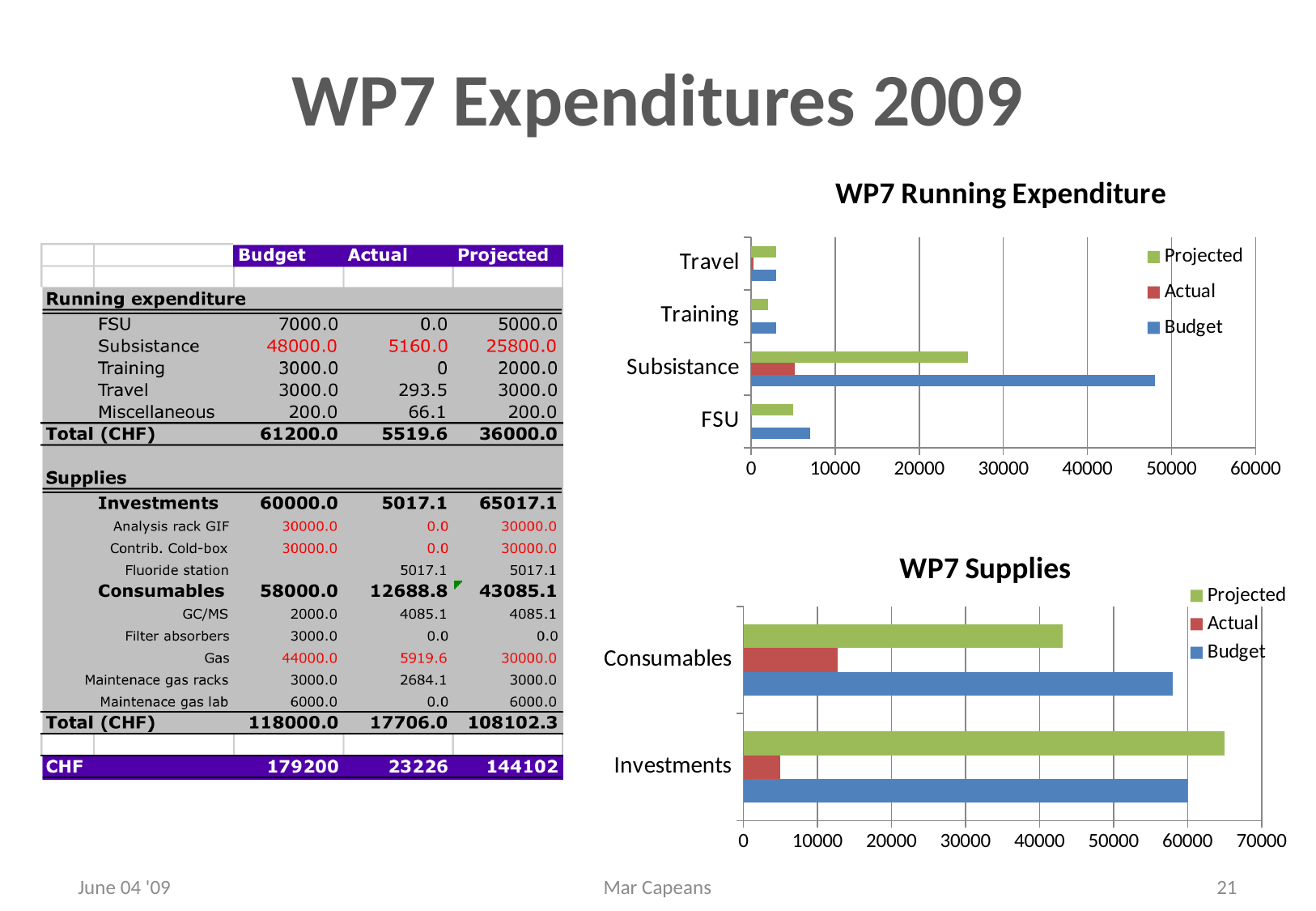
What type of chart is the WP7 Running Expenditure chart? bar chart In the WP7 Running Expenditure chart, which category has the longest Budget bar? Subsistance In the WP7 Supplies chart, is the Actual value for Consumables greater or less than 10000? greater In the WP7 Running Expenditure chart, is the Budget value for FSU greater or less than 10000? less In the WP7 Supplies chart, is the Projected value for Investments greater or less than 60000? greater Which series is shown in green in the WP7 Supplies chart legend? Projected In the WP7 Running Expenditure chart, which is larger for Subsistance, the Budget bar or the Projected bar? Budget In the WP7 Supplies chart, which category has the longer Projected bar? Investments How many series does the legend of the WP7 Running Expenditure chart list? 3 How many categories are shown on the WP7 Running Expenditure chart? 4 How many categories are shown on the WP7 Supplies chart? 2